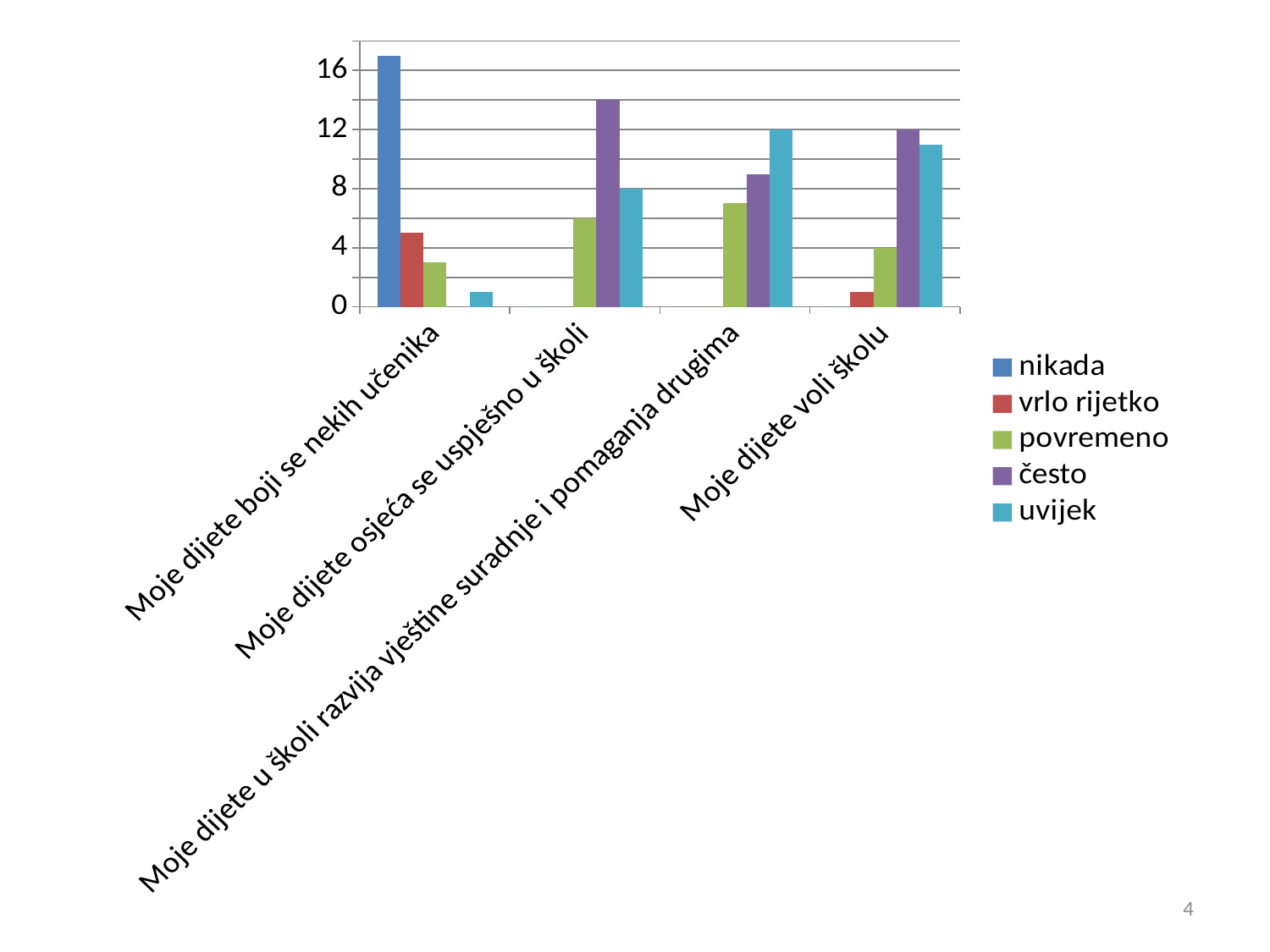
Which series has the highest bar for "Moje dijete boji se nekih učenika"? nikada How many categories are shown on the x axis? 4 Which series has the highest bar for "Moje dijete u školi razvija vještine suradnje i pomaganja drugima"? uvijek Is the value of "povremeno" for "Moje dijete u školi razvija vještine suradnje i pomaganja drugima" greater or less than 8? less What kind of chart is shown on the slide? bar chart Is the value of "često" for "Moje dijete osjeća se uspješno u školi" greater or less than 12? greater For "Moje dijete voli školu", which is larger: the "često" bar or the "povremeno" bar? često Is the value of "nikada" for "Moje dijete boji se nekih učenika" greater or less than 16? greater Which series is shown in purple in the legend? često How many series does the legend list? 5 For "Moje dijete osjeća se uspješno u školi", which is larger: the "uvijek" bar or the "povremeno" bar? uvijek